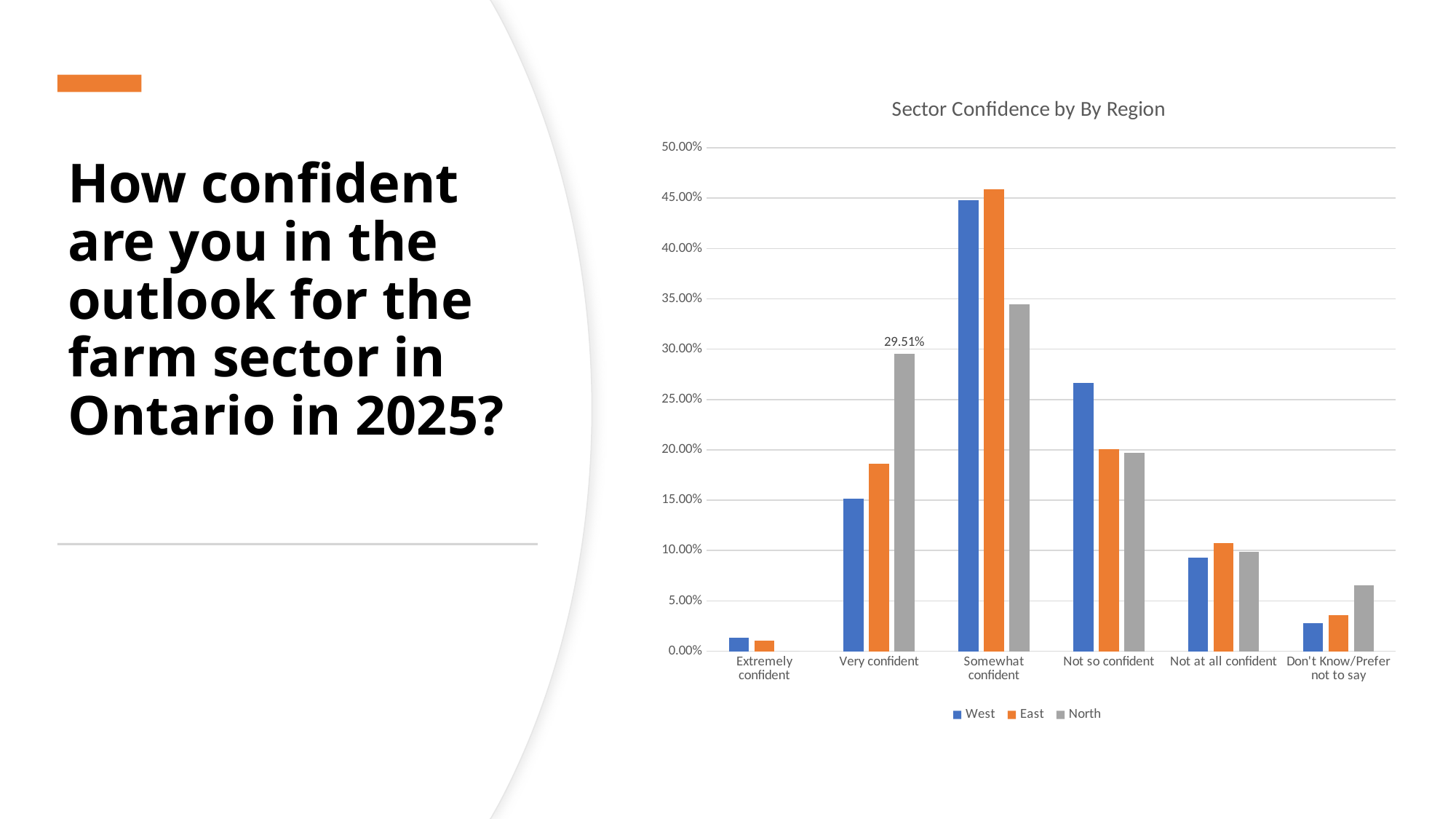
What is the value for North in the Very confident category? 29.51% What kind of chart is shown on the slide? Bar chart What is the title of the chart? Sector Confidence by By Region Is the value for West in the Not so confident category greater or less than 25.00%? greater Which region has the highest value in the Very confident category? North Is the value for East in the Very confident category greater or less than 20.00%? less In the Not so confident category, which is larger, West or North? West How many categories are shown on the x axis? 6 Which region has the lowest value in the Somewhat confident category? North Which category has the lowest value for East? Extremely confident Which category has the highest value for West? Somewhat confident How many series does the legend list? 3